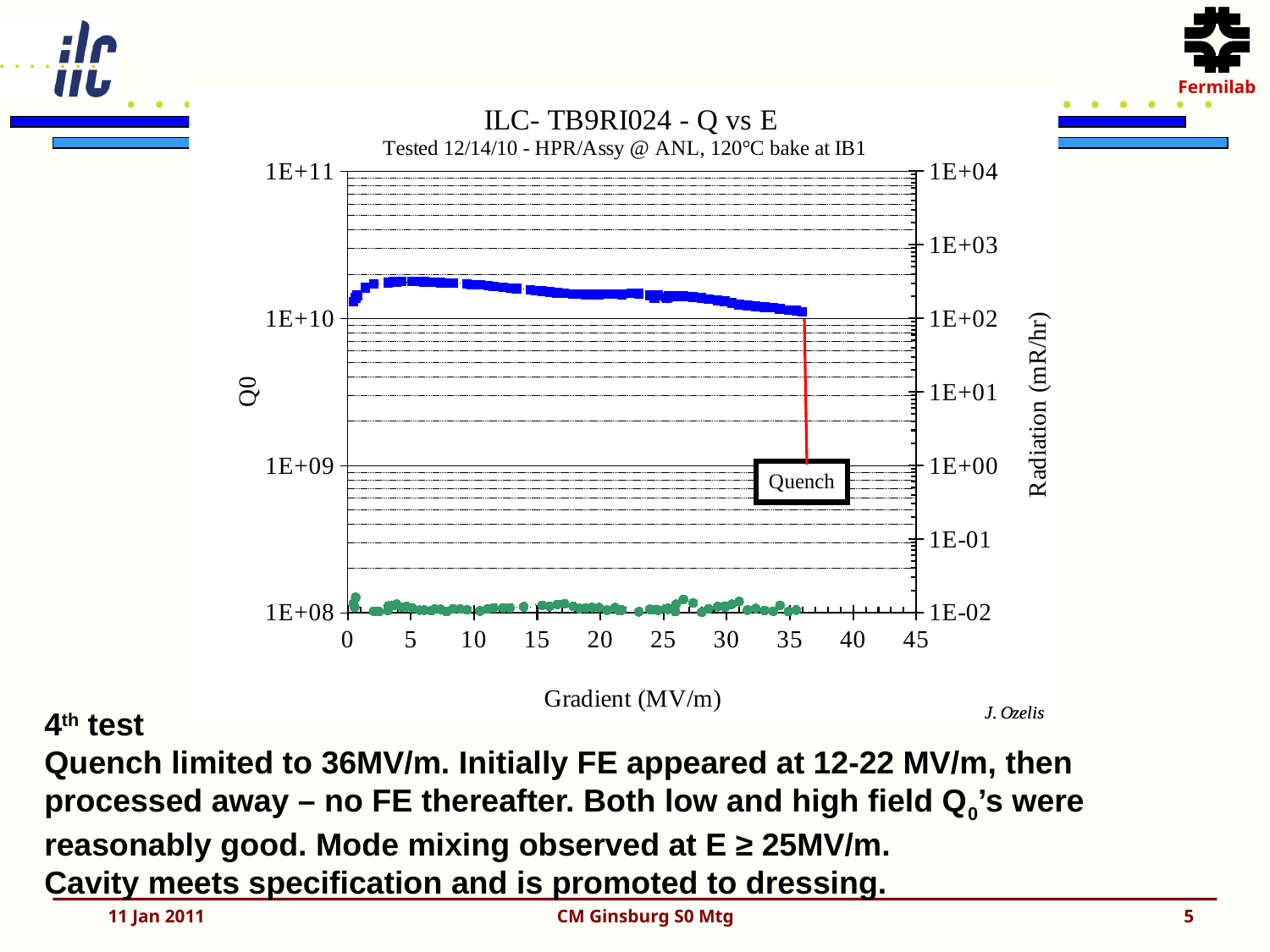
Is the radiation value at a gradient of 20 MV/m greater or less than 1E-01 mR/hr? less Is the Q0 value at a gradient of 5 MV/m greater or less than 1E+10? greater Is the Q0 value at a gradient of 1 MV/m greater or less than 1E+10? greater What is the title of the chart? ILC- TB9RI024 - Q vs E What kind of chart is shown on the slide? scatter chart Does the Q0 series rise or fall as the gradient increases from 10 MV/m to 35 MV/m? fall Which is larger, the Q0 value at 5 MV/m or the Q0 value at 35 MV/m? 5 MV/m What label is shown in the boxed annotation next to the red vertical line? Quench